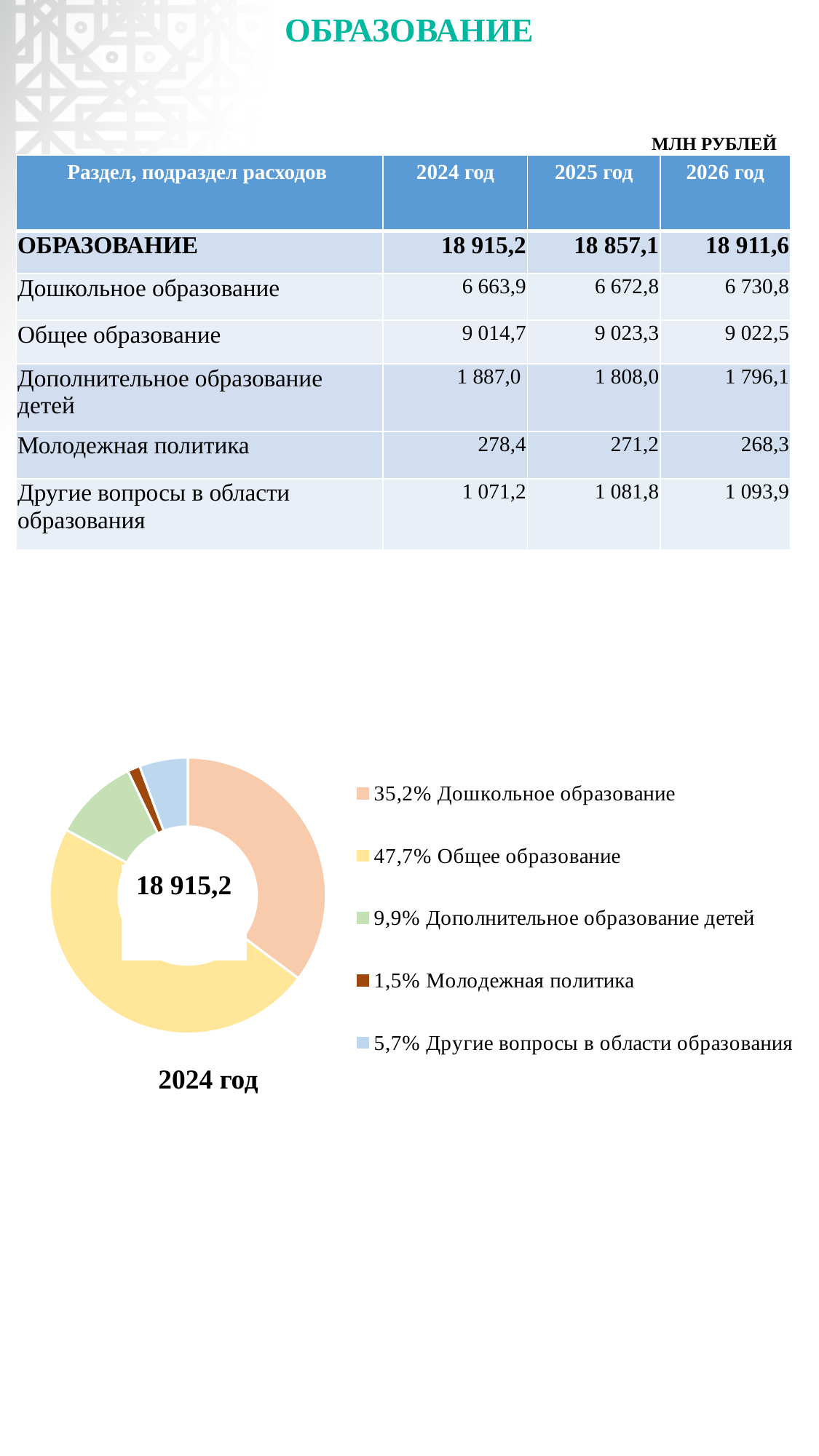
What share of the 2024 doughnut chart does Другие вопросы в области образования take? 5,7% What share of the 2024 doughnut chart does Общее образование take? 47,7% What share of the 2024 doughnut chart does Дошкольное образование take? 35,2% What total value is printed in the centre of the doughnut chart? 18 915,2 Which slice is larger in the doughnut chart: Дополнительное образование детей or Другие вопросы в области образования? Дополнительное образование детей What kind of chart is shown on the slide? doughnut chart Which year does the doughnut chart represent, according to the label below it? 2024 год Which category has the largest slice in the 2024 doughnut chart? Общее образование Which category has the smallest slice in the 2024 doughnut chart? Молодежная политика How many categories does the legend of the doughnut chart list? 5